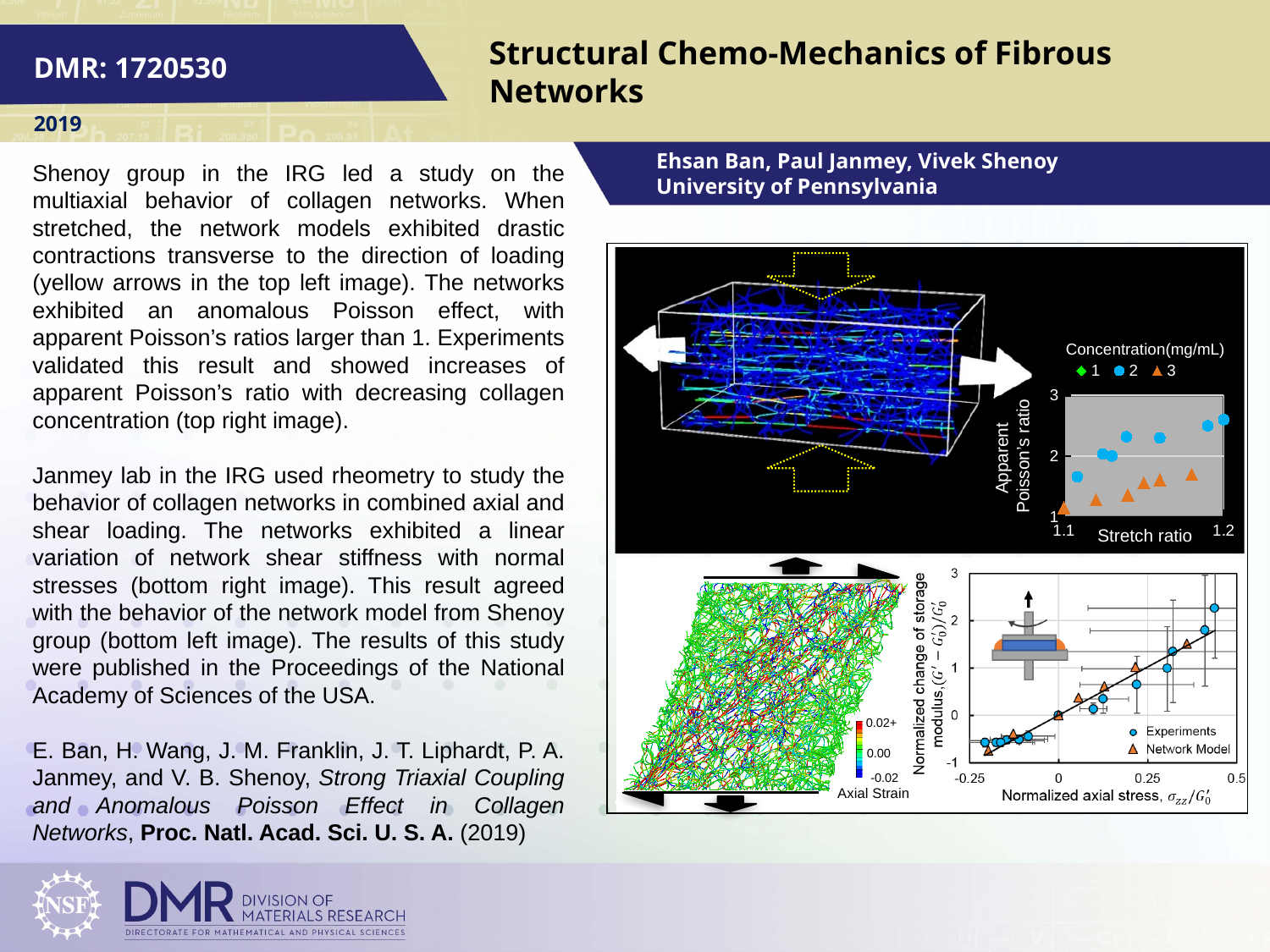
In the bottom right chart of Normalized change of storage modulus versus Normalized axial stress, how many series does the legend list? 2 What kind of chart is the bottom right chart of Normalized change of storage modulus versus Normalized axial stress? scatter plot In the top right chart of Apparent Poisson's ratio versus Stretch ratio, what is the title of the legend? Concentration(mg/mL) In the top right chart of Apparent Poisson's ratio versus Stretch ratio, do the apparent Poisson's ratio values rise or fall as the stretch ratio increases? rise What kind of chart is the top right chart of Apparent Poisson's ratio versus Stretch ratio? scatter plot In the top right chart of Apparent Poisson's ratio versus Stretch ratio, are the apparent Poisson's ratio values for concentration 3 greater or less than 2? less In the bottom right chart of Normalized change of storage modulus versus Normalized axial stress, which marker shape represents the Network Model series? triangles In the bottom right chart of Normalized change of storage modulus versus Normalized axial stress, does the normalized change of storage modulus rise or fall as the normalized axial stress increases? rise In the top right chart of Apparent Poisson's ratio versus Stretch ratio, which series has the larger apparent Poisson's ratio values, concentration 2 or concentration 3? concentration 2 In the top right chart of Apparent Poisson's ratio versus Stretch ratio, how many concentration series does the legend list? 3 In the bottom right chart of Normalized change of storage modulus versus Normalized axial stress, is the value at a normalized axial stress of -0.25 greater or less than 0? less